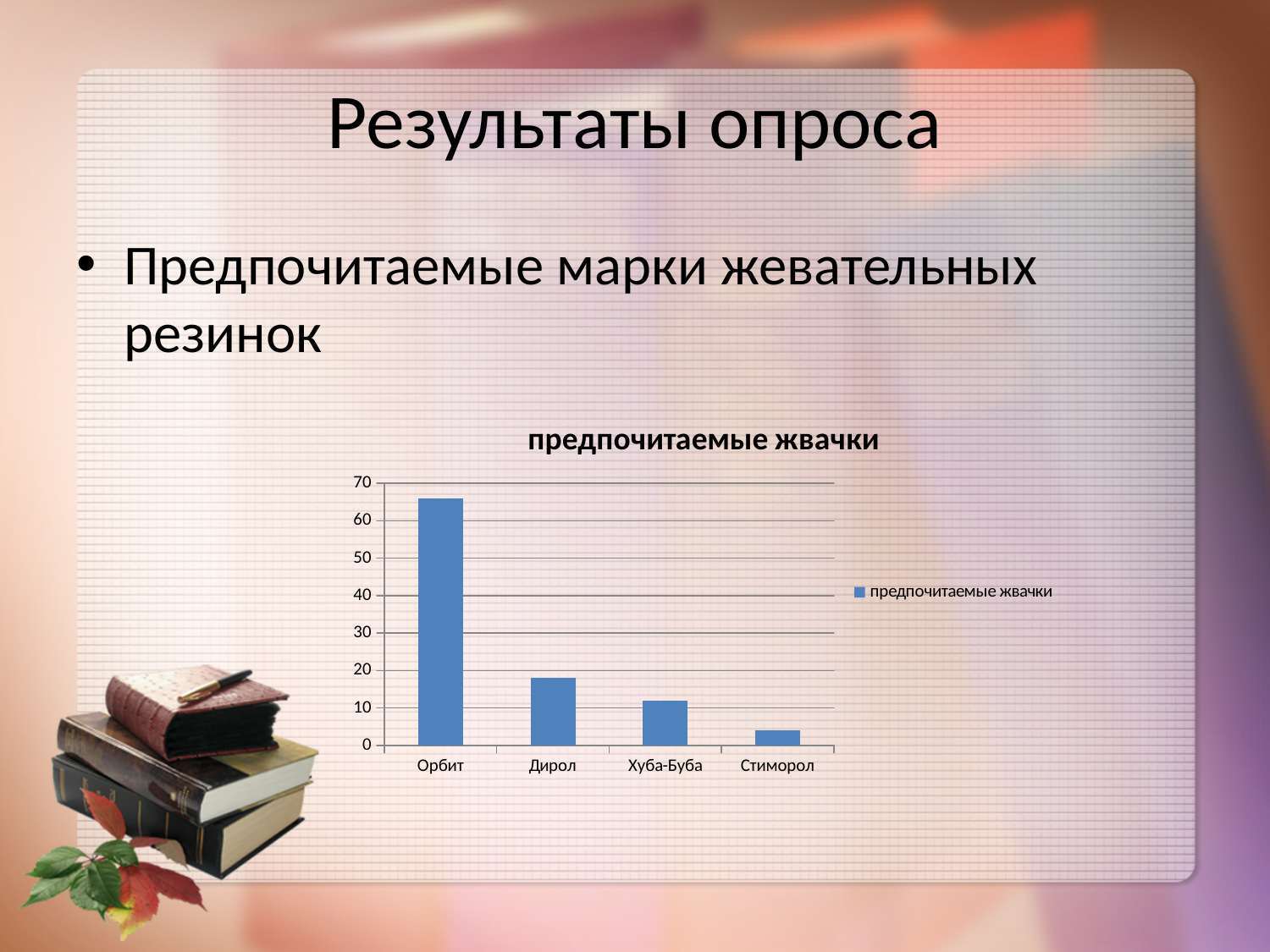
Which brand has the lowest value in the chart? Стиморол What kind of chart is shown on the slide? bar chart Is the value for Стиморол greater or less than 10? less How many brands (categories) are shown on the x axis? 4 What is the title of the chart? предпочитаемые жвачки Do the values rise or fall moving from left to right along the x axis? fall Is the value for Дирол greater or less than 20? less Is the value for Орбит greater or less than 60? greater Which brand has the highest value in the chart? Орбит How many series does the legend list? 1 Which is larger, the value for Дирол or the value for Хуба-Буба? Дирол